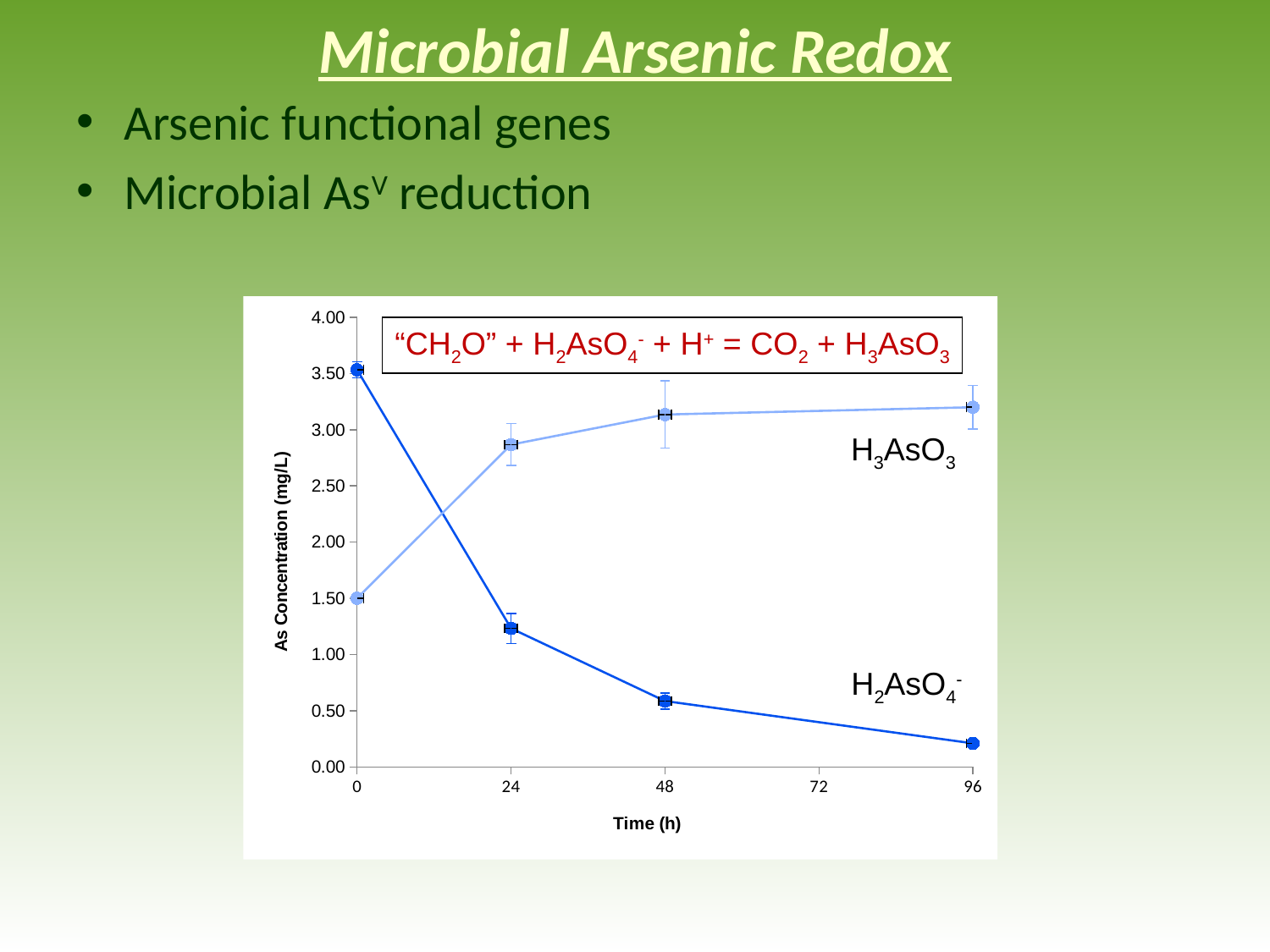
Is the H2AsO4- concentration at 24 h greater or less than 1.50 mg/L? less What is the label of the x axis? Time (h) At 0 h, which series has the higher As concentration, H3AsO3 or H2AsO4-? H2AsO4- Does the H2AsO4- concentration rise or fall over time? fall How many series are plotted on the chart? 2 What kind of chart is shown on the slide? line chart At 96 h, which series has the higher As concentration, H3AsO3 or H2AsO4-? H3AsO3 What is the label of the y axis? As Concentration (mg/L) Is the H3AsO3 concentration at 48 h greater or less than 3.00 mg/L? greater How many time points are plotted for each series? 4 Does the H3AsO3 concentration rise or fall over time? rise Is the H2AsO4- concentration at 96 h greater or less than 0.50 mg/L? less